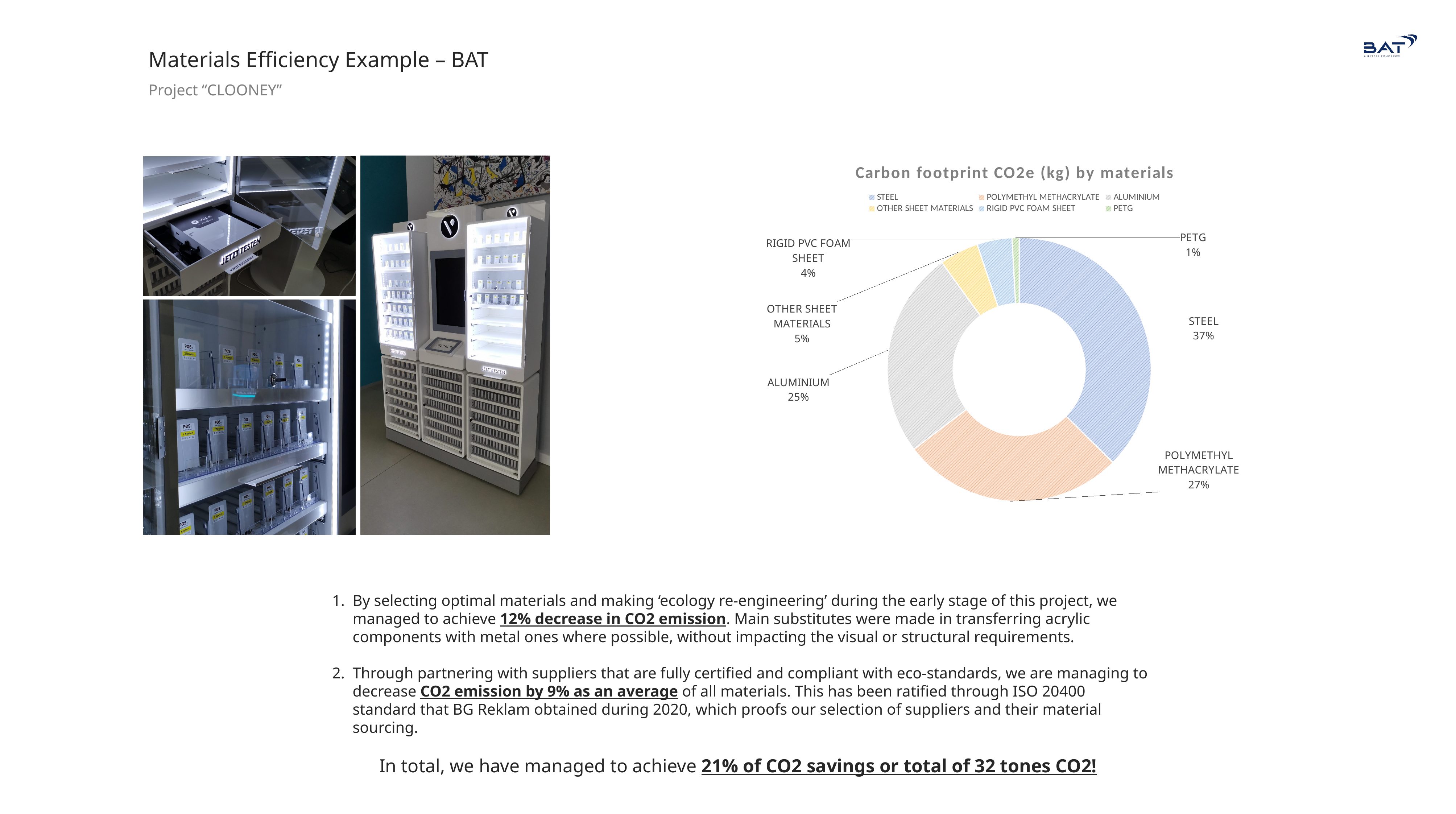
What share of the carbon footprint does OTHER SHEET MATERIALS account for? 5% What is the difference in percentage points between the STEEL and ALUMINIUM shares? 12 percentage points What share of the carbon footprint does ALUMINIUM account for? 25% Which material has the smallest share of the carbon footprint? PETG What share of the carbon footprint does POLYMETHYL METHACRYLATE account for? 27% Which material has the largest share of the carbon footprint? STEEL What is the title of the chart on the slide? Carbon footprint CO2e (kg) by materials What kind of chart is shown on the slide? Doughnut (pie) chart How many materials are shown in the chart? 6